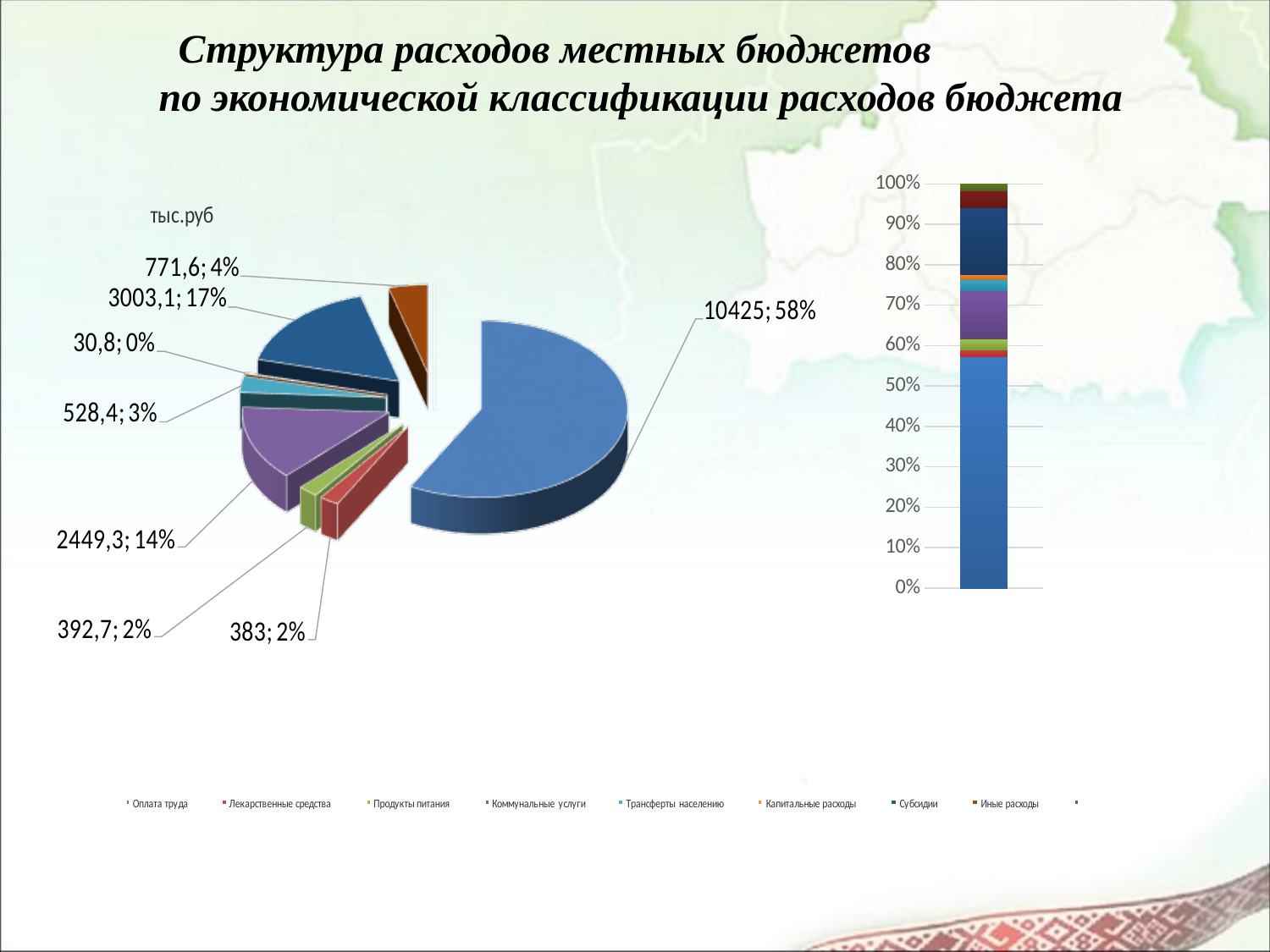
What kind of chart is the chart on the right of the slide? stacked bar chart In the pie chart, what share does the largest slice (Оплата труда) have? 58% In the pie chart, what is the difference between the slice labelled 3003,1 and the slice labelled 2449,3? 553,8 In the pie chart, what is the data label of the largest slice? 10425; 58% How many slices does the pie chart have? 8 What kind of chart is the chart on the left of the slide? pie chart In the pie chart, what is the data label of the smallest slice? 30,8; 0% In the stacked bar chart on the right, is the top of the bottom blue segment greater or less than 50%? greater In the pie chart, what share does the dark blue slice (Субсидии) have? 17% In the pie chart, which is larger: the slice for Иные расходы (771,6) or the slice for Трансферты населению (528,4)? Иные расходы (771,6) In the pie chart, what is the value of the purple slice (Коммунальные услуги)? 2449,3 What unit is shown above the pie chart? тыс.руб